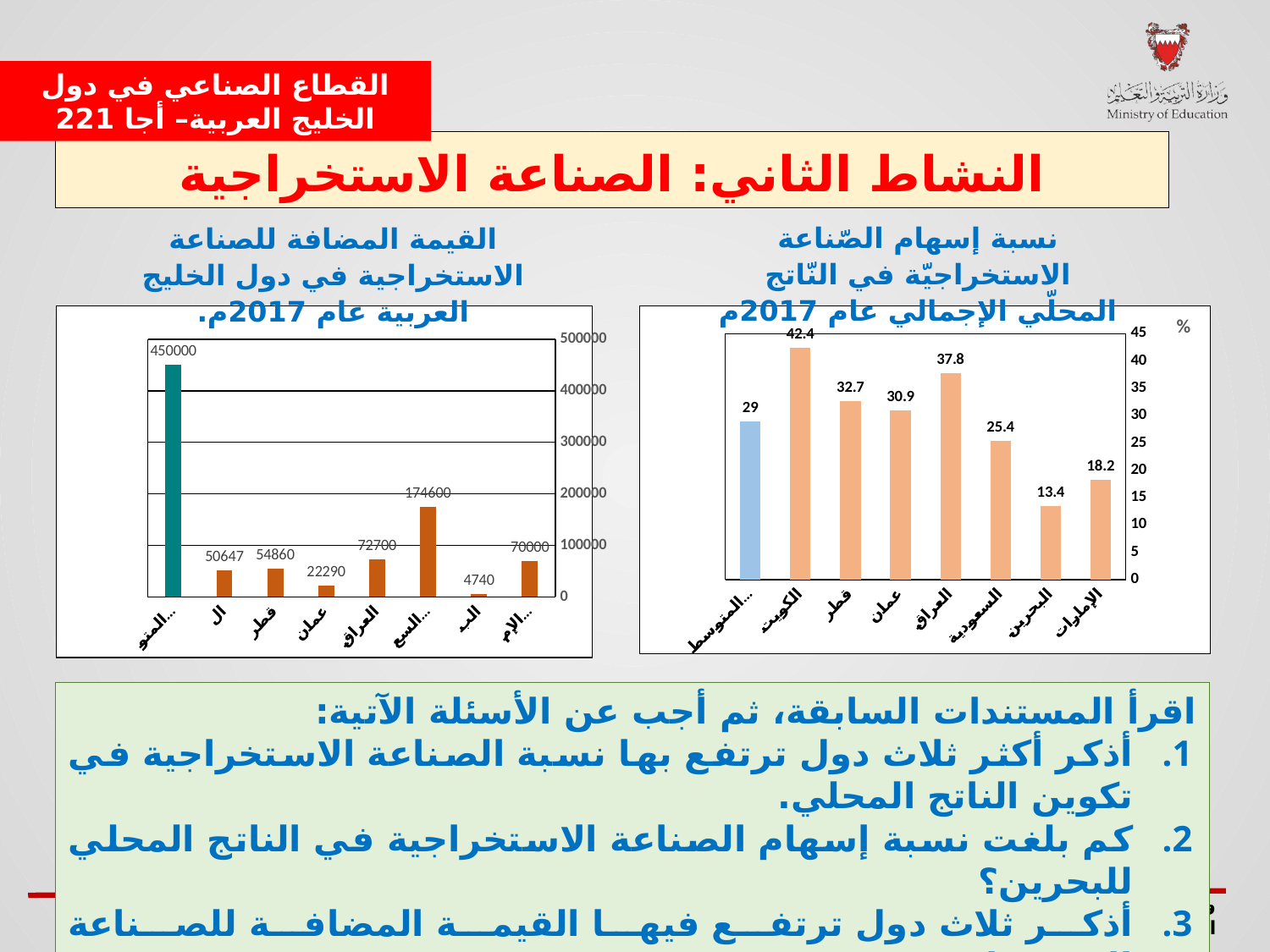
In the right chart (نسبة إسهام الصّناعة الاستخراجيّة), what is the difference between the values for العراق and السعودية? 12.4 In the right chart (نسبة إسهام الصّناعة الاستخراجيّة), which is larger, the value for قطر or the value for عمان? قطر In the left chart (القيمة المضافة للصناعة الاستخراجية), what is the difference between the values for قطر and عمان? 32570 In the right chart (نسبة إسهام الصّناعة الاستخراجيّة), what is the value for البحرين? 13.4 In the right chart (نسبة إسهام الصّناعة الاستخراجيّة), how many bars are plotted? 8 In the right chart (نسبة إسهام الصّناعة الاستخراجيّة), which country has the highest value? الكويت In the left chart (القيمة المضافة للصناعة الاستخراجية), what is the value for قطر? 54860 In the left chart (القيمة المضافة للصناعة الاستخراجية), what is the highest value shown on the vertical axis? 500000 In the left chart (القيمة المضافة للصناعة الاستخراجية في دول الخليج العربية عام 2017م), what is the value for العراق? 72700 In the right chart (نسبة إسهام الصّناعة الاستخراجيّة), which country has the lowest value? البحرين What kind of chart is the right chart (نسبة إسهام الصّناعة الاستخراجيّة)? bar chart In the right chart (نسبة إسهام الصّناعة الاستخراجيّة في النّاتج المحلّي الإجمالي عام 2017م), what is the value for الكويت? 42.4